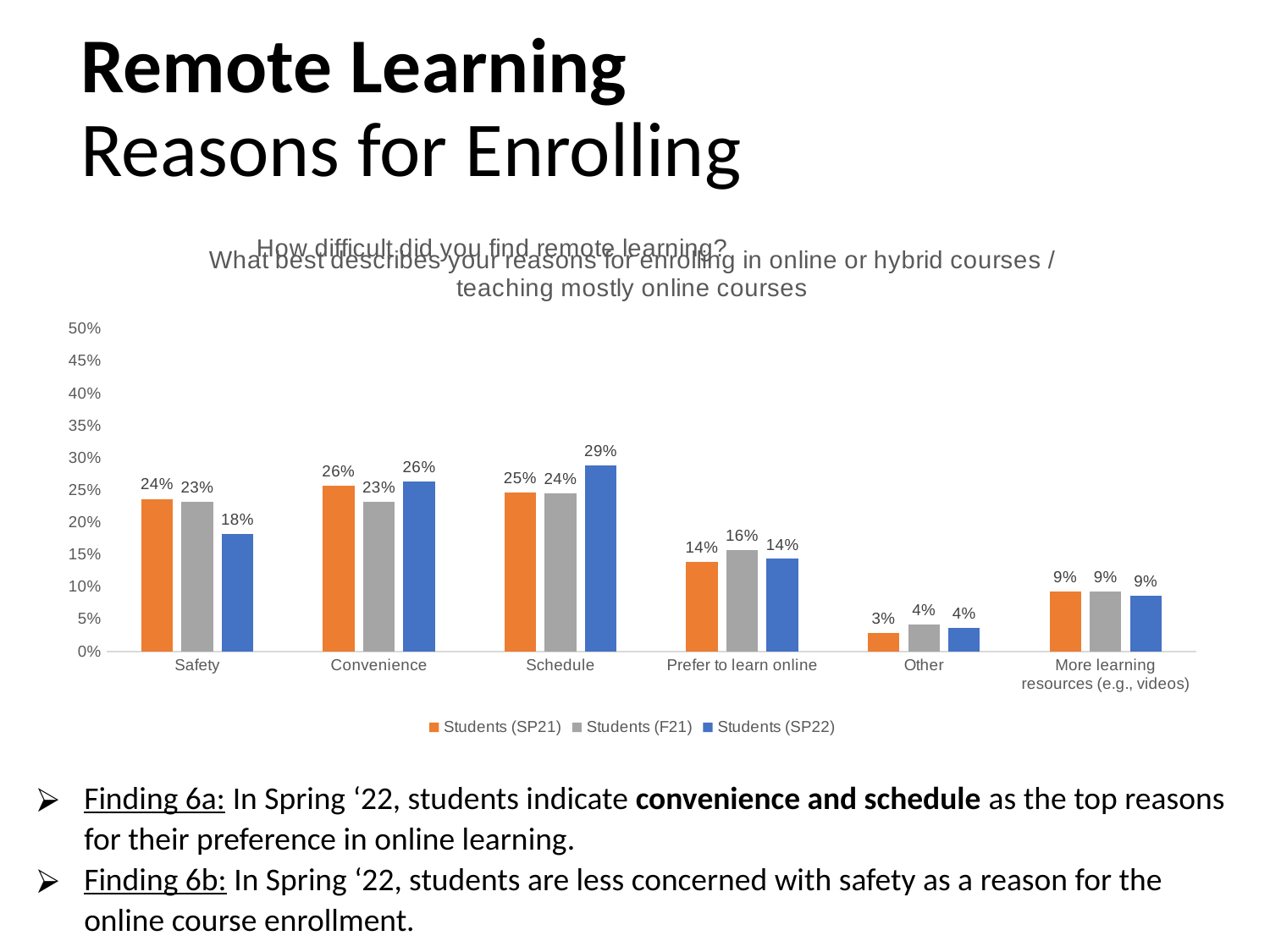
Which category has the lowest value for Students (SP21)? Other Is the value for Students (SP22) in the Schedule category greater or less than 25%? greater Which category has the highest value for Students (SP22)? Schedule How many series does the legend list? 3 What is the difference between the Students (SP22) and Students (SP21) values for Schedule? 4% Which colour represents Students (SP22) in the chart? Blue What kind of chart is shown on the slide? Bar chart How many categories are shown on the x axis? 6 What is the value for Students (SP22) in the Safety category? 18% What is the value for Students (F21) in the Prefer to learn online category? 16% What is the value for Students (SP21) in the Other category? 3% Which is larger for Safety: the Students (SP21) value or the Students (SP22) value? Students (SP21)